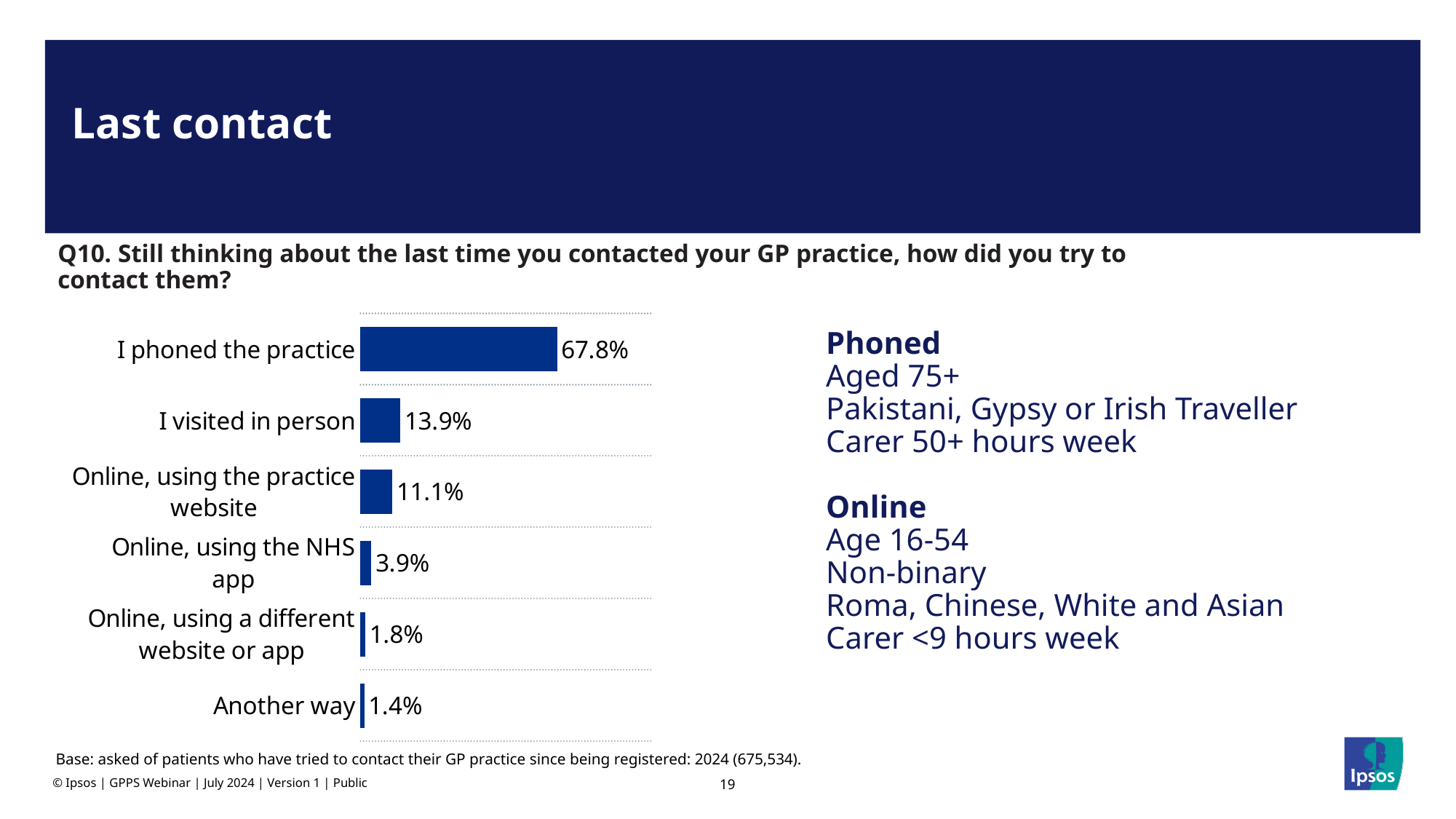
What is the value for 'I visited in person'? 13.9% What is the difference between 'Online, using the practice website' and 'Online, using the NHS app'? 7.2 percentage points Which is larger: 'Online, using a different website or app' or 'Another way'? Online, using a different website or app Which contact method has the lowest percentage? Another way What percentage contacted the practice online using the practice website? 11.1% What type of chart is shown on the slide? Bar chart What is the difference between 'I phoned the practice' and 'I visited in person'? 53.9 percentage points What percentage contacted the practice 'Another way'? 1.4% How many contact methods are shown in the chart? 6 Which contact method has the highest percentage? I phoned the practice What percentage of patients said they phoned the practice? 67.8% What is the value for 'Online, using the NHS app'? 3.9%